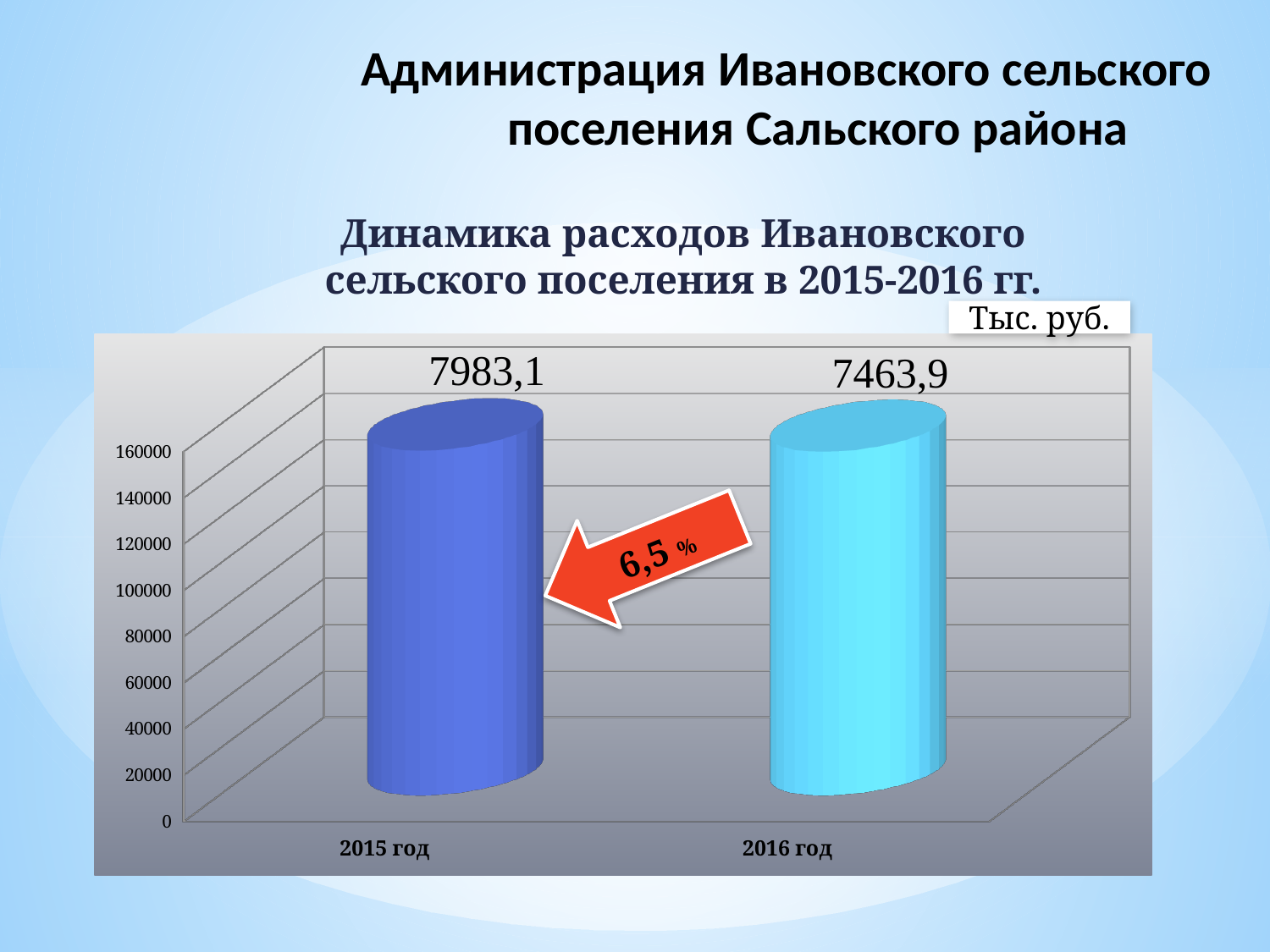
Which is larger, the value for 2015 год or for 2016 год? 2015 год What percentage is written on the red arrow in the chart? 6,5 % How many categories are shown on the x axis? 2 What kind of chart is shown on the slide? Bar chart What unit is indicated above the chart? Тыс. руб. Which year has the highest value? 2015 год Do the values rise or fall from 2015 год to 2016 год? Fall Which year has the lowest value? 2016 год What is the value for 2015 год? 7983,1 What is the value for 2016 год? 7463,9 What is the difference between the values for 2015 год and 2016 год? 519,2